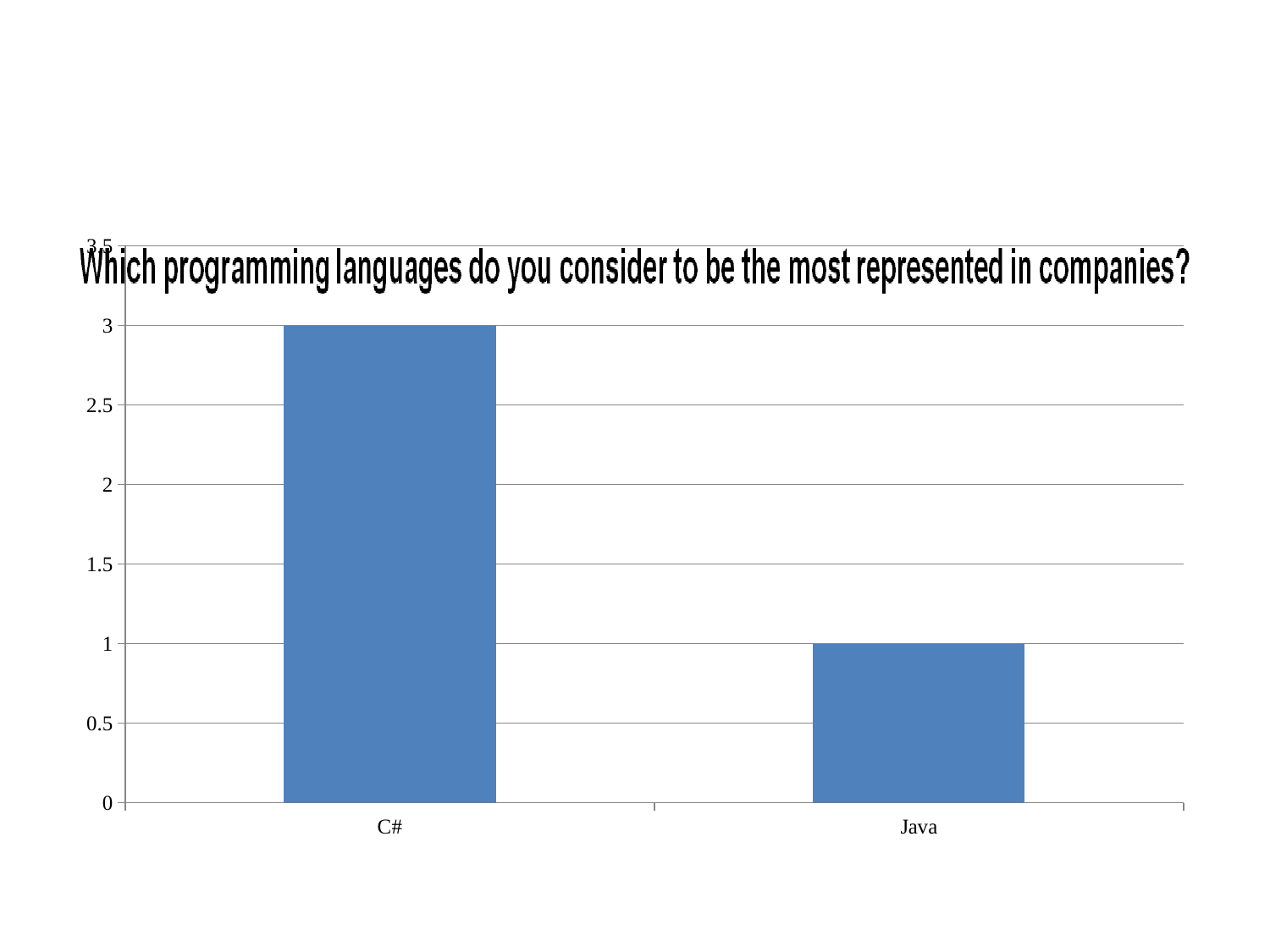
What is the value for C#? 3 What is the title of the chart? Which programming languages do you consider to be the most represented in companies? What is the difference between the values for C# and Java? 2 What kind of chart is shown on the slide? bar chart Which is larger, the value for C# or the value for Java? C# How many categories are shown on the x axis? 2 Is the value for Java greater or less than 2? less Is the value for C# greater or less than 2? greater What is the highest value shown on the y axis? 3.5 Which category has the highest value? C# What is the value for Java? 1 Which category has the lowest value? Java